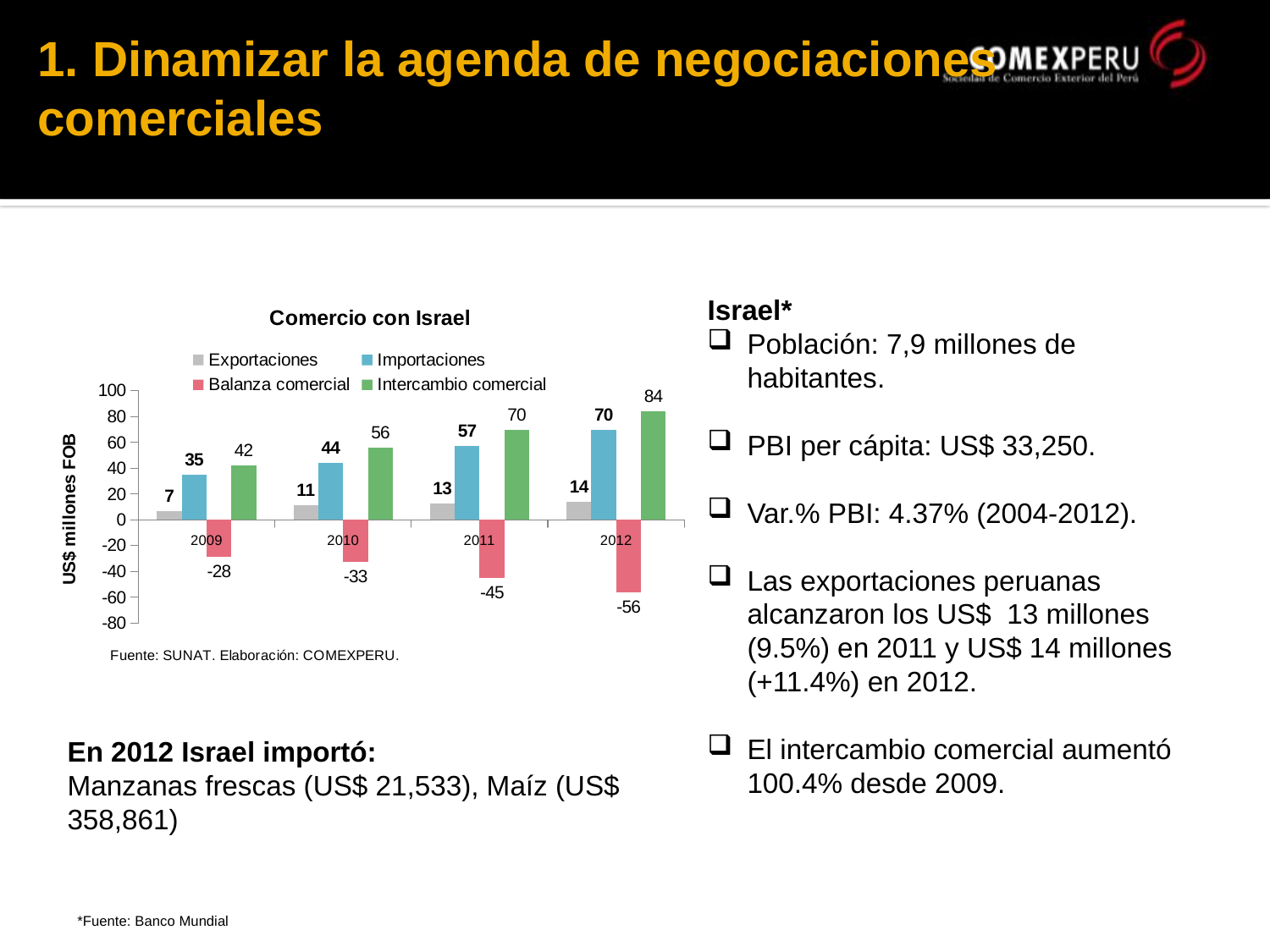
What is the value of Balanza comercial in 2011? -45 Do the Balanza comercial values rise or fall from 2009 to 2012? Fall Which is larger, Intercambio comercial in 2011 or Intercambio comercial in 2010? Intercambio comercial in 2011 Which year has the highest Intercambio comercial value? 2012 What is the value of Intercambio comercial in 2010? 56 Which year has the lowest Exportaciones value? 2009 What kind of chart is shown? Bar chart What is the difference between Importaciones in 2012 and Importaciones in 2009? 35 How many series does the legend list? 4 What is the value of Importaciones in 2012? 70 What is the value of Exportaciones in 2009? 7 How many years are shown on the x axis? 4